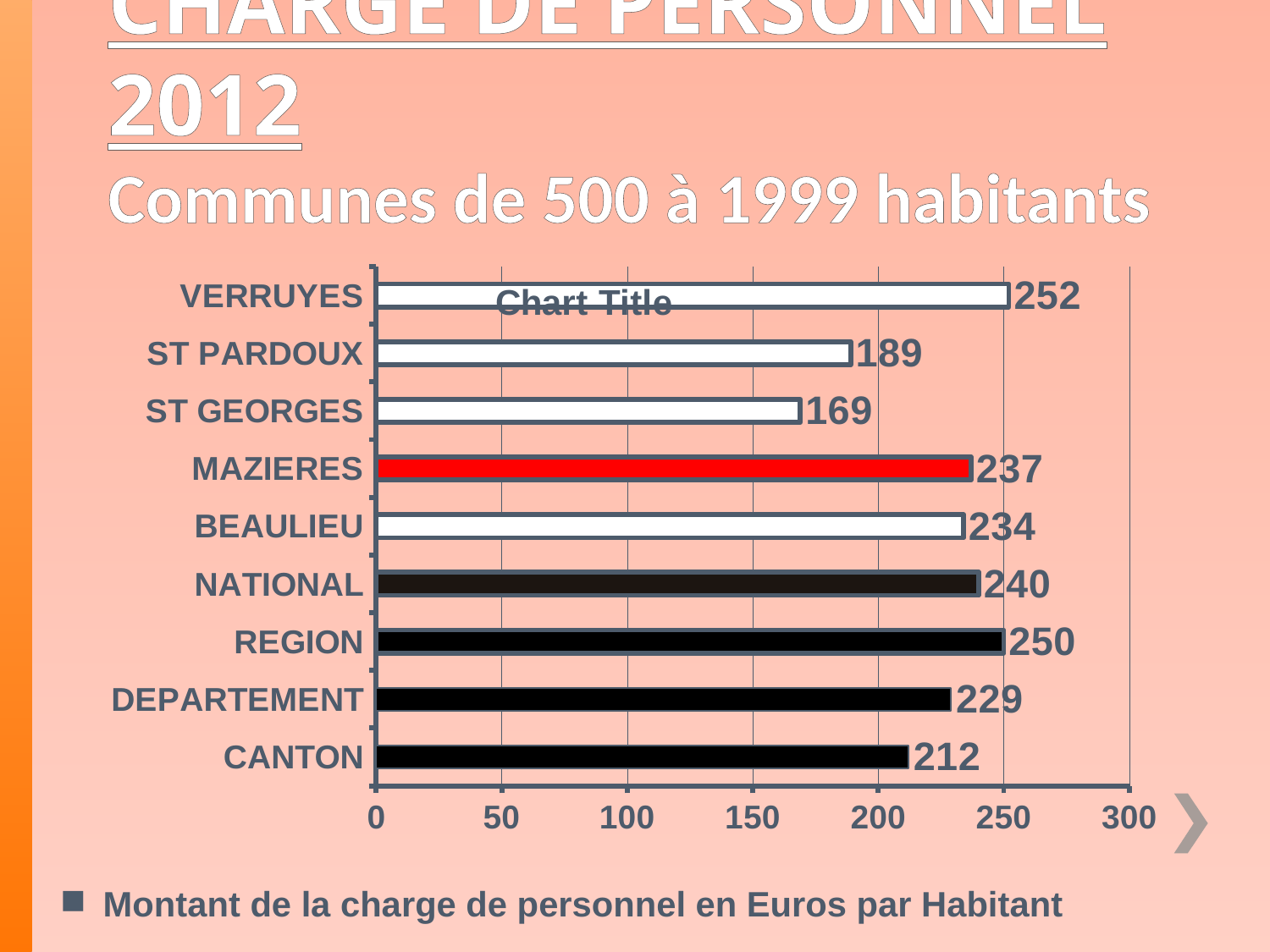
Is the value for ST PARDOUX greater or less than 200? less Which category has the highest value? VERRUYES What kind of chart is shown on the slide? bar chart What is the difference between the values for VERRUYES and ST PARDOUX? 63 Which category has the lowest value? ST GEORGES Which is larger, the value for NATIONAL or the value for BEAULIEU? NATIONAL What is the value for MAZIERES? 237 What is the difference between the values for REGION and DEPARTEMENT? 21 How many categories are shown in the chart? 9 What is the value for ST GEORGES? 169 Which bar is coloured red? MAZIERES What is the value for CANTON? 212